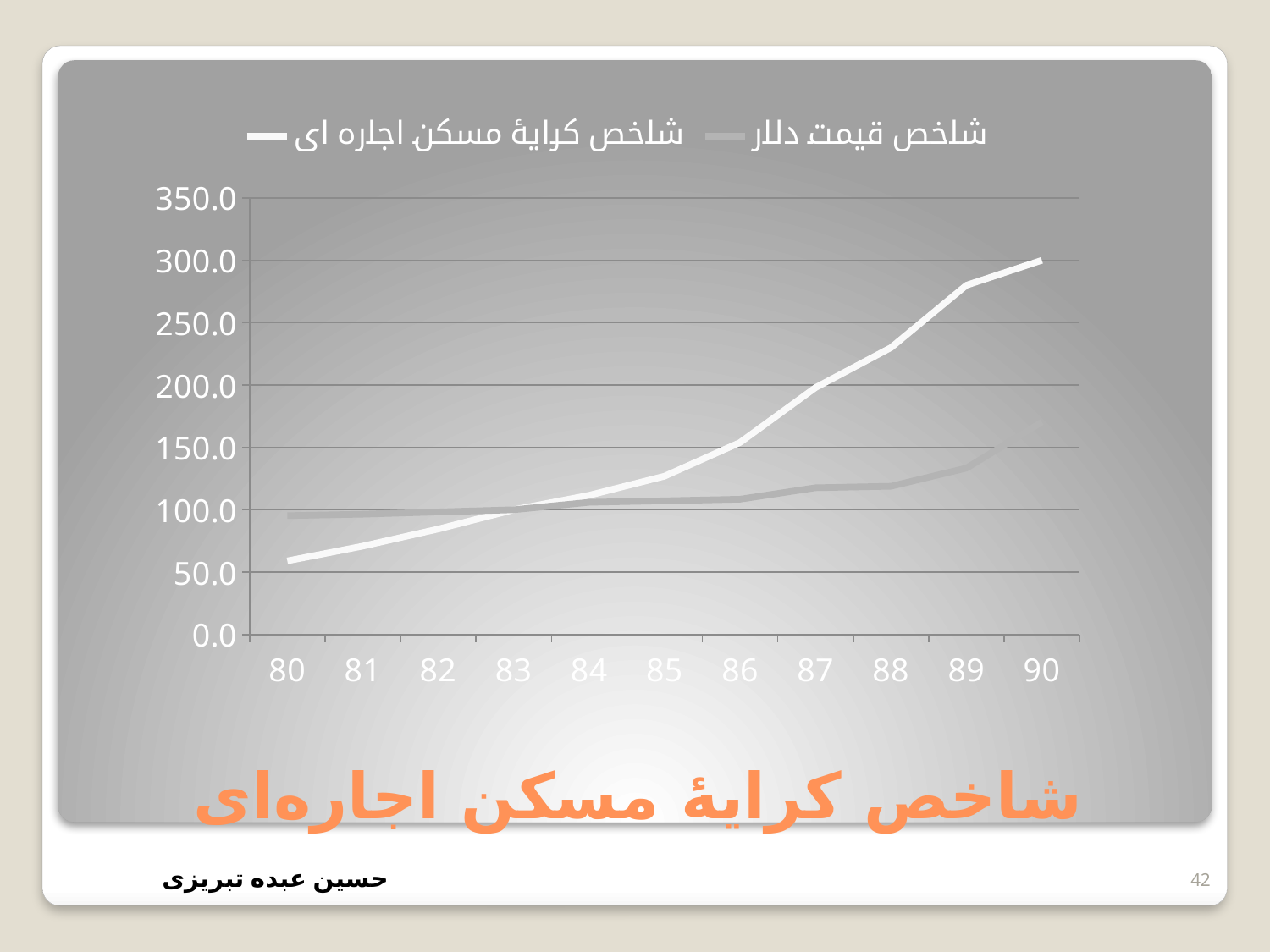
Is the value of شاخص کرایۀ مسکن اجاره ای at 90 greater or less than 250.0? greater How many years are shown along the x axis? 11 Is the value of شاخص قیمت دلار at 90 greater or less than 200.0? less How many series does the legend list? 2 In which year is شاخص کرایۀ مسکن اجاره ای at its highest? 90 Does the شاخص کرایۀ مسکن اجاره ای series rise or fall from 80 to 90? rise Is the value of شاخص کرایۀ مسکن اجاره ای at 80 greater or less than 100.0? less At 90, which series has the higher value, شاخص کرایۀ مسکن اجاره ای or شاخص قیمت دلار? شاخص کرایۀ مسکن اجاره ای What kind of chart is shown on the slide? line chart Which series is drawn with the white line? شاخص کرایۀ مسکن اجاره ای At 80, which series has the higher value, شاخص کرایۀ مسکن اجاره ای or شاخص قیمت دلار? شاخص قیمت دلار In which year is شاخص کرایۀ مسکن اجاره ای at its lowest? 80